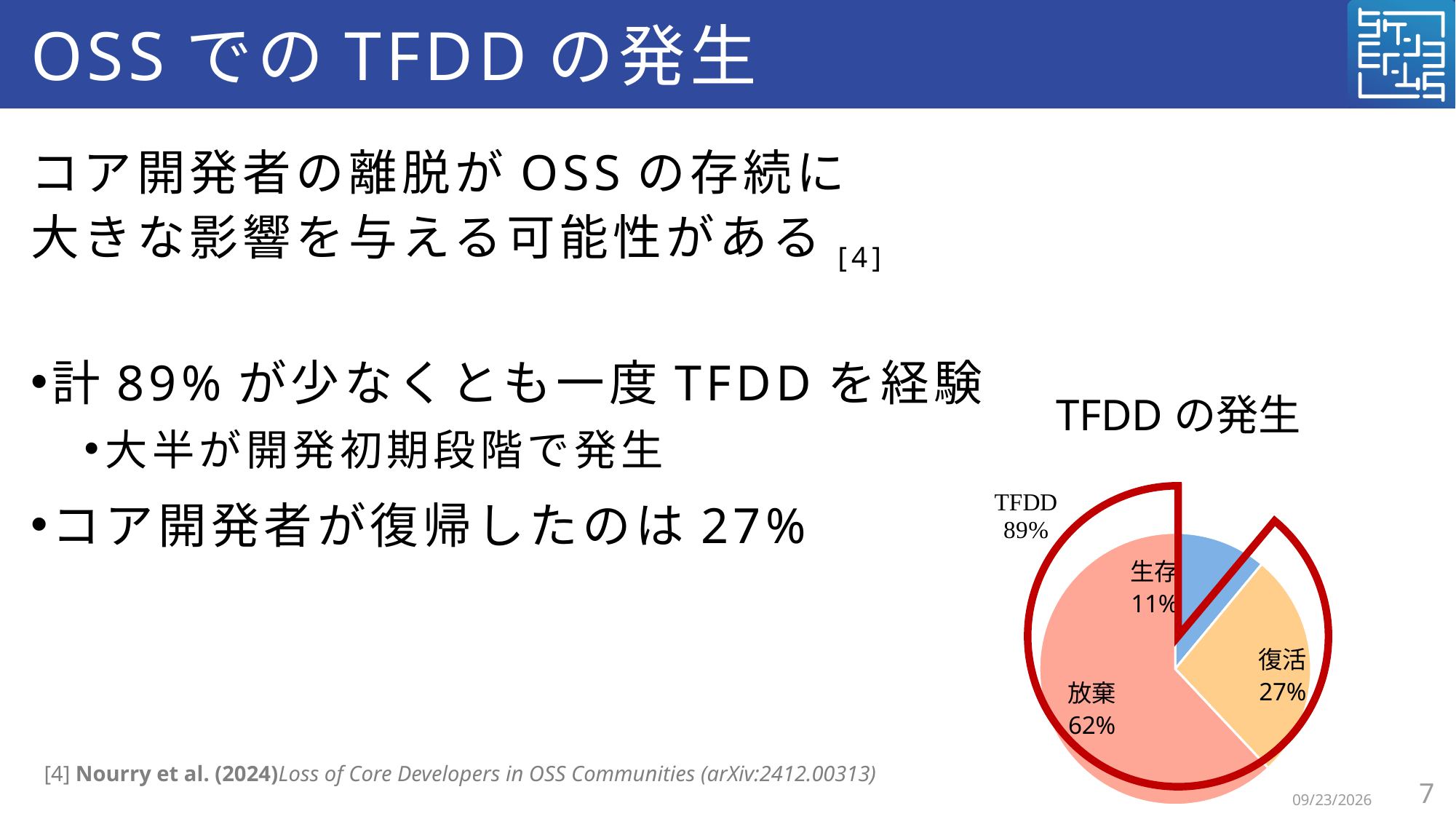
What is the combined share of 放棄 and 復活? 89% What share of the pie is 放棄? 62% What is the difference between the 放棄 share and the 復活 share? 35% How many slices does the pie chart have? 3 What percentage is written next to the TFDD label outlined in red on the pie chart? 89% Which slice of the pie chart is the smallest? 生存 What is the title of the chart? TFDD の発生 What share of the pie is 生存? 11% What share of the pie is 復活? 27% What kind of chart is shown on the slide? pie chart Which is larger, 復活 or 生存? 復活 Which slice of the pie chart is the largest? 放棄